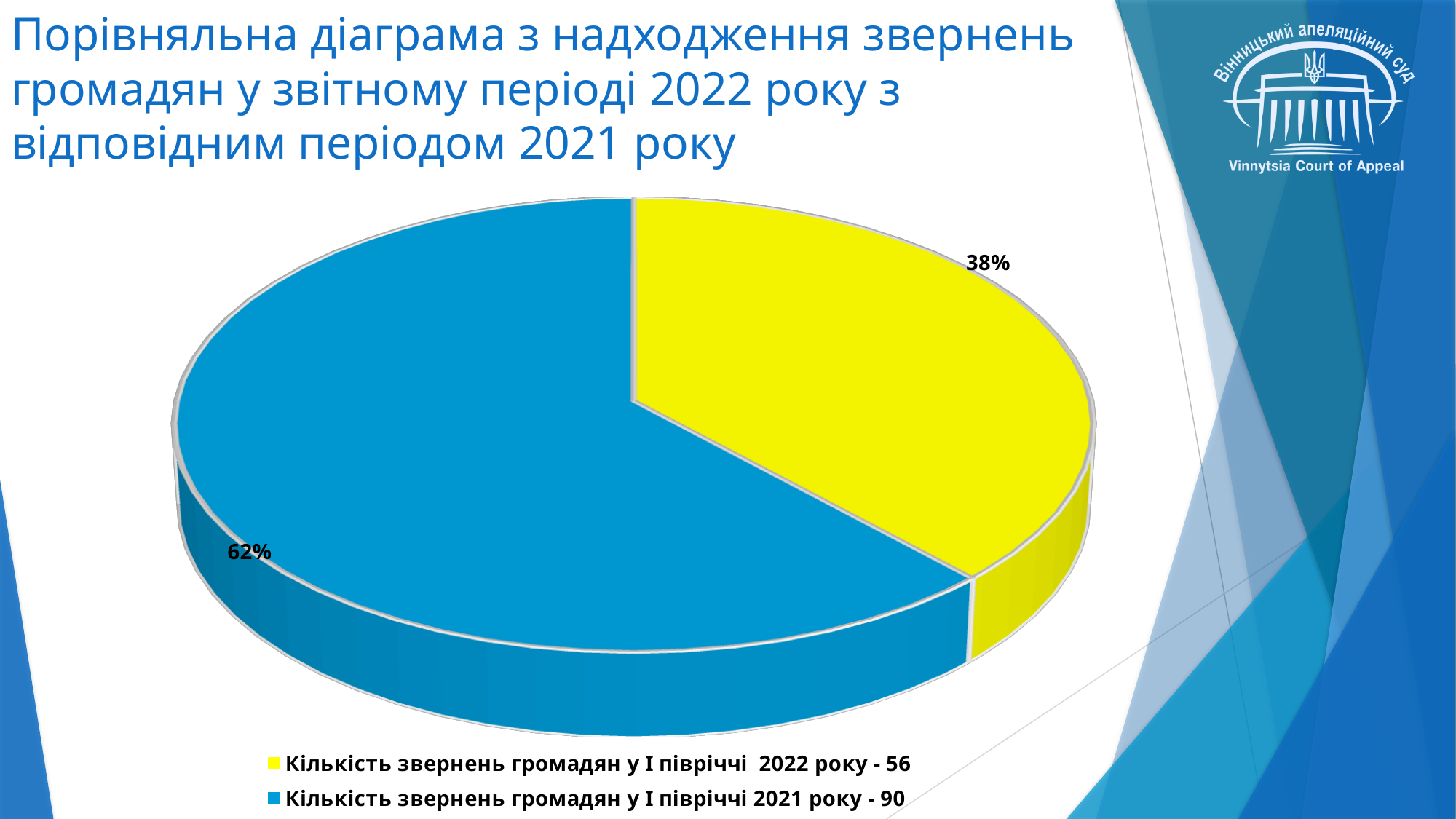
How many entries does the legend list? 2 What is the difference between the number of appeals in the first half of 2021 (90) and the first half of 2022 (56)? 34 What is the difference in percentage points between the 2021 slice (62%) and the 2022 slice (38%)? 24 Which period has the smallest share of the pie? the first half of 2022 What percentage share does the slice for the first half of 2022 (Кількість звернень громадян у І півріччі 2022 року) have? 38% According to the legend, how many citizen appeals were received in the first half of 2022? 56 According to the legend, how many citizen appeals were received in the first half of 2021? 90 What kind of chart is shown on the slide? pie chart Which period has the larger slice of the pie, the first half of 2021 or the first half of 2022? the first half of 2021 What percentage share does the slice for the first half of 2021 (Кількість звернень громадян у І півріччі 2021 року) have? 62% How many slices does the pie chart have? 2 What colour is the slice representing the first half of 2022? yellow